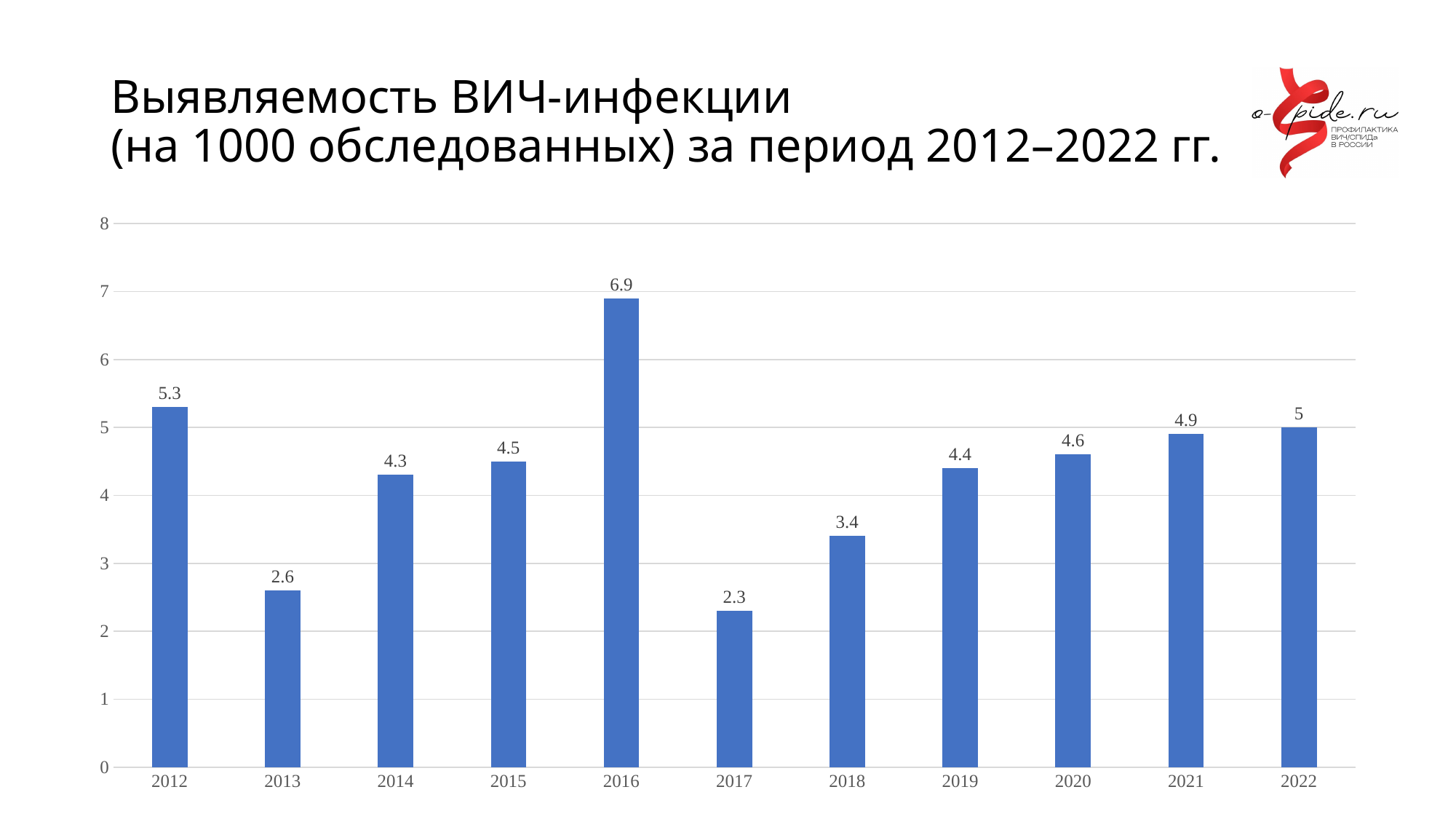
Which year has the lowest value? 2017 Is the value for 2018 greater or less than 4? less What is the title of the chart? Выявляемость ВИЧ-инфекции (на 1000 обследованных) за период 2012–2022 гг. How many years are shown on the x axis? 11 What is the value for 2016? 6.9 What is the value for 2022? 5 What is the difference between the values for 2016 and 2017? 4.6 Do the values rise or fall from 2017 to 2022? rise What kind of chart is shown on the slide? bar chart Which is larger, the value for 2012 or the value for 2014? 2012 Which year has the highest value? 2016 What is the value for 2013? 2.6